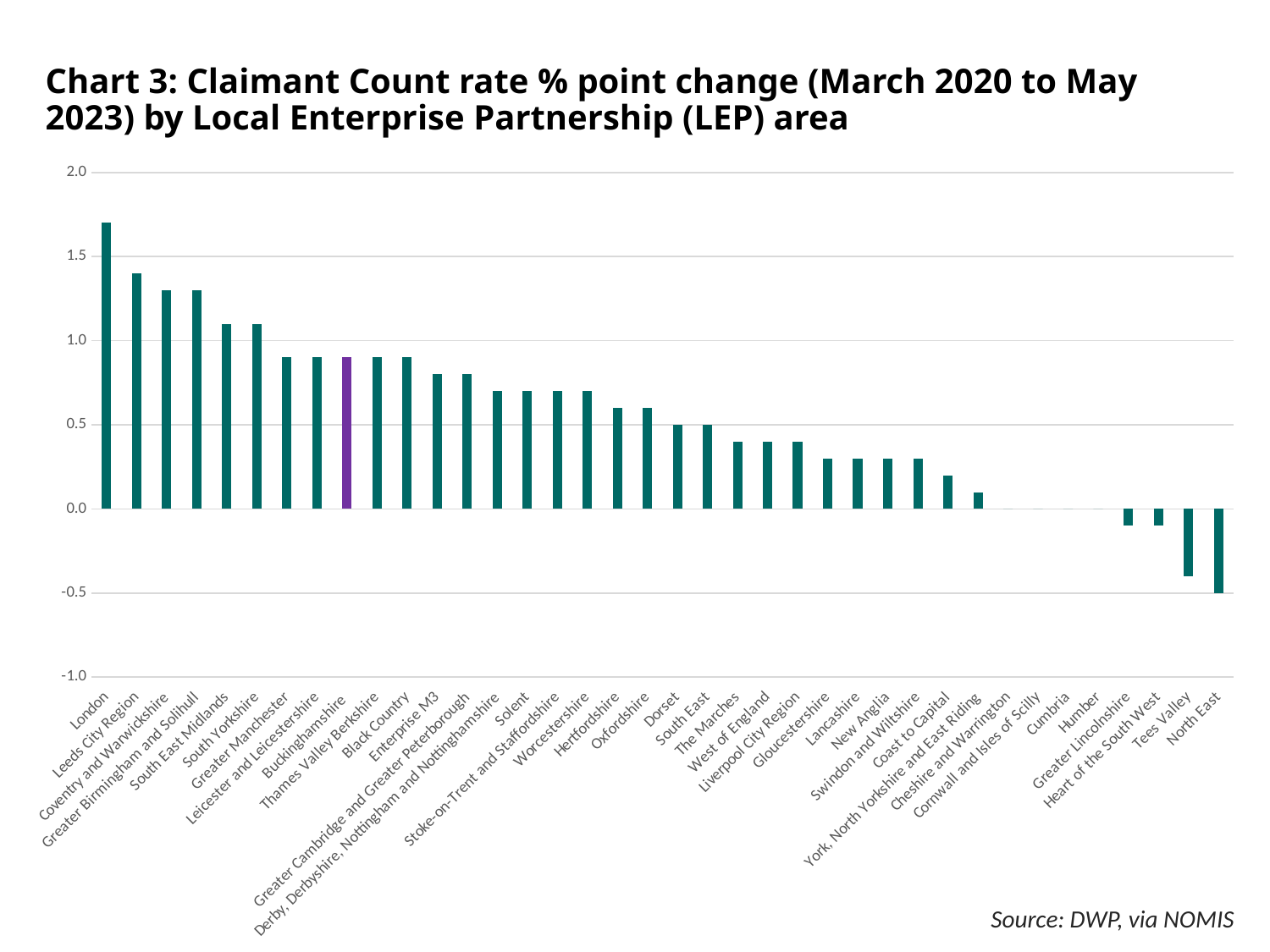
What kind of chart is shown on the slide? Bar chart Which LEP area has the lowest Claimant Count rate % point change? North East Which has the larger value, Coast to Capital or York, North Yorkshire and East Riding? Coast to Capital Is the value for Buckinghamshire greater or less than 1.0? less Is the value for Tees Valley greater or less than 0.0? less Which LEP area has the highest Claimant Count rate % point change? London Which LEP area's bar is highlighted in purple rather than green? Buckinghamshire Is the value for London greater or less than 1.5? greater Which has the larger value, London or Leeds City Region? London Do the values generally rise or fall moving from left to right along the x axis? Fall